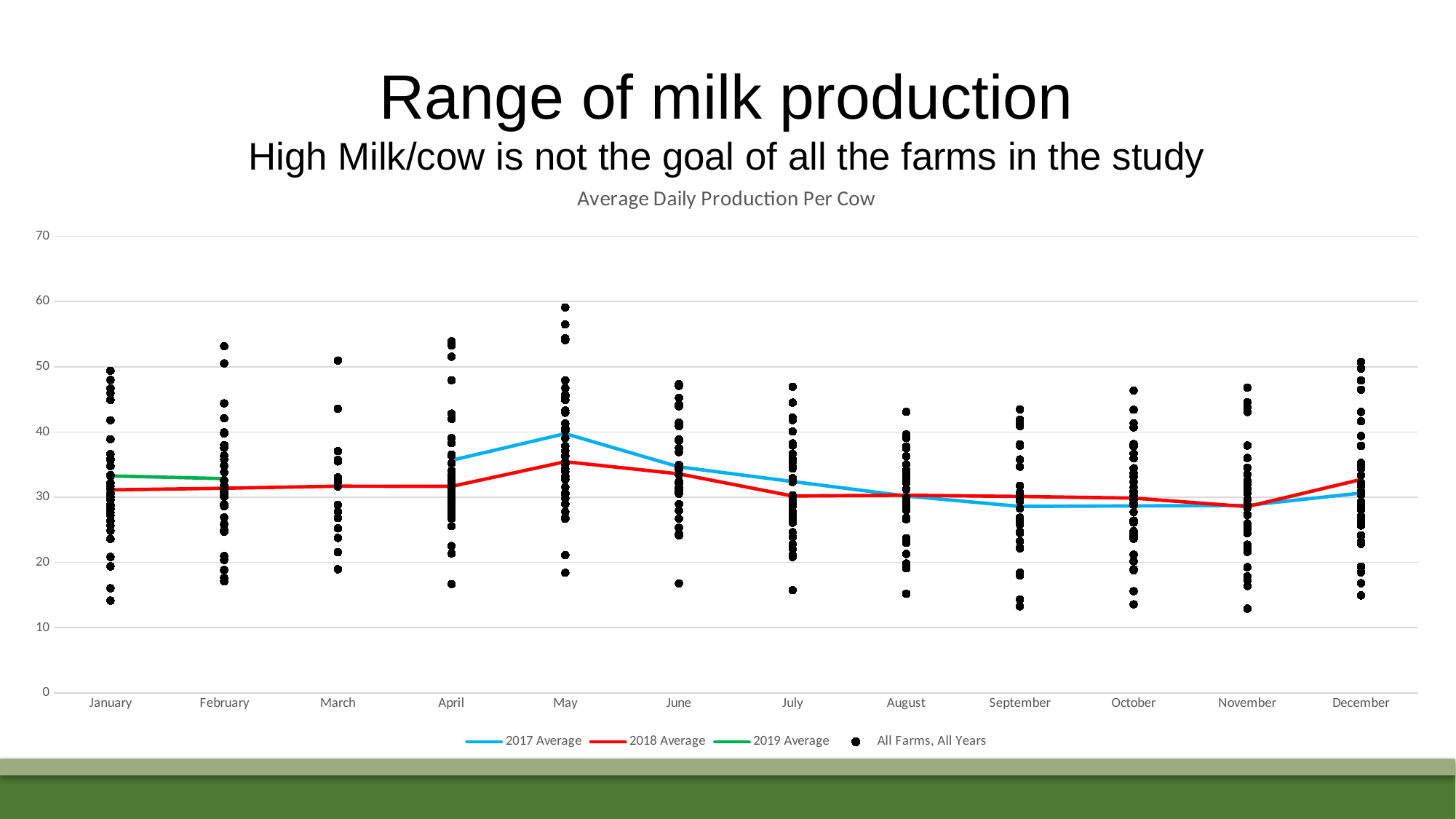
Which series is plotted as black dots rather than a line? All Farms, All Years In May, which is larger: the 2017 Average or the 2018 Average? 2017 Average In which month does the highest individual farm data point appear? May What is the title of the chart? Average Daily Production Per Cow Is the 2018 Average value for November greater or less than 30? less Is the 2017 Average value for May greater or less than 30? greater How many months are shown along the x axis of the chart? 12 What kind of chart is shown on the slide? Line chart Does the 2017 Average line rise or fall from May to September? Fall In which month does the 2017 Average line reach its highest value? May In which month does the 2018 Average line reach its highest value? May How many series does the chart legend list? 4